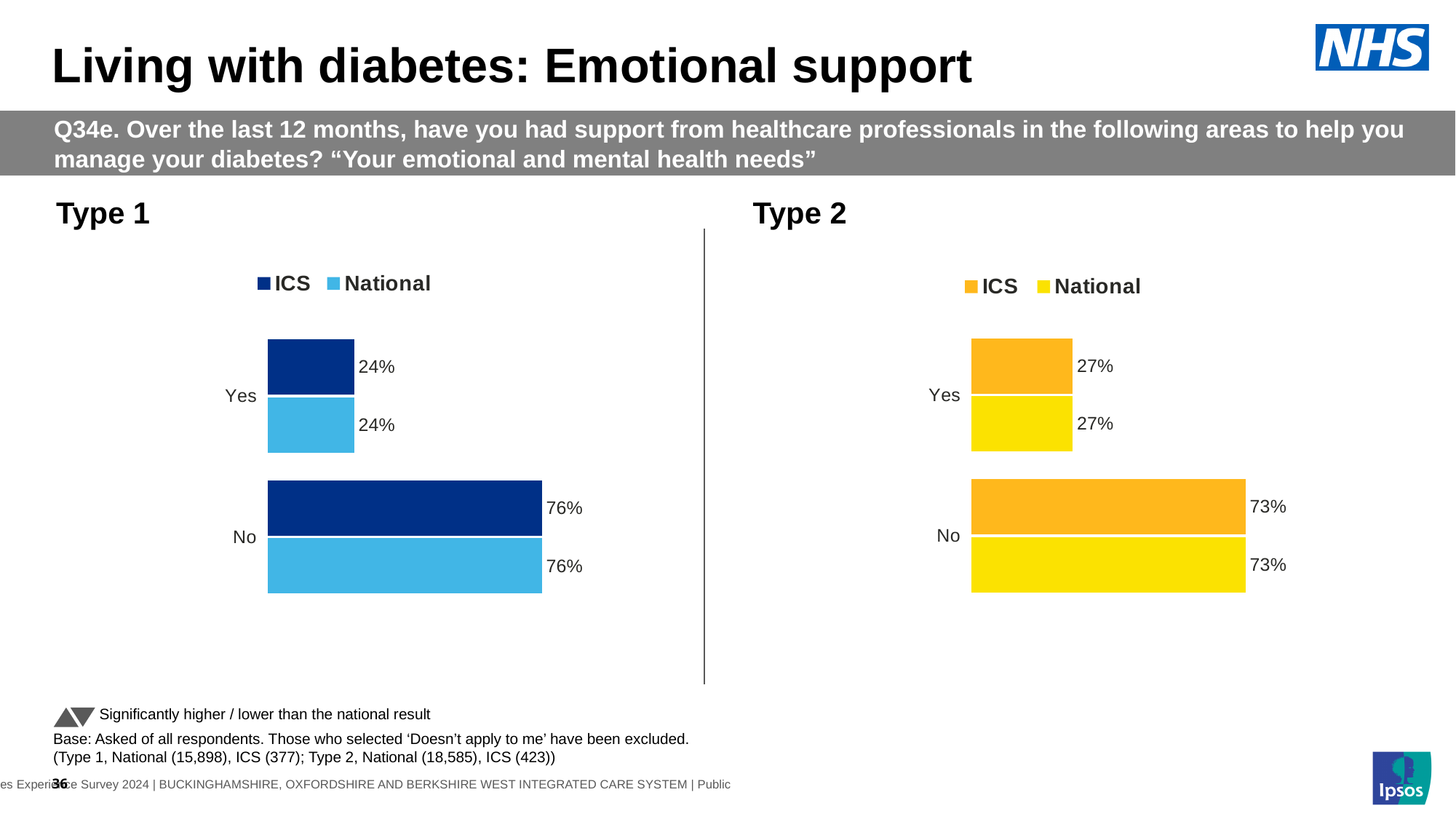
In the Type 2 chart, what is the ICS value for Yes? 27% In the Type 2 chart, what is the National value for No? 73% In the Type 2 chart, what is the difference between the ICS values for No and Yes? 46 percentage points How many series does the legend of the Type 1 chart list? 2 In the Type 2 chart, which is larger: the ICS value for No or the ICS value for Yes? No In the Type 2 chart, which category has the lowest National value? Yes In the Type 1 chart, what is the National value for No? 76% In the Type 1 chart, what is the ICS value for Yes? 24% In the Type 1 chart, which category has the highest ICS value? No How many categories are shown in the Type 2 chart? 2 In the Type 1 chart, what is the difference between the ICS values for No and Yes? 52 percentage points What kind of chart is the Type 1 chart? Bar chart